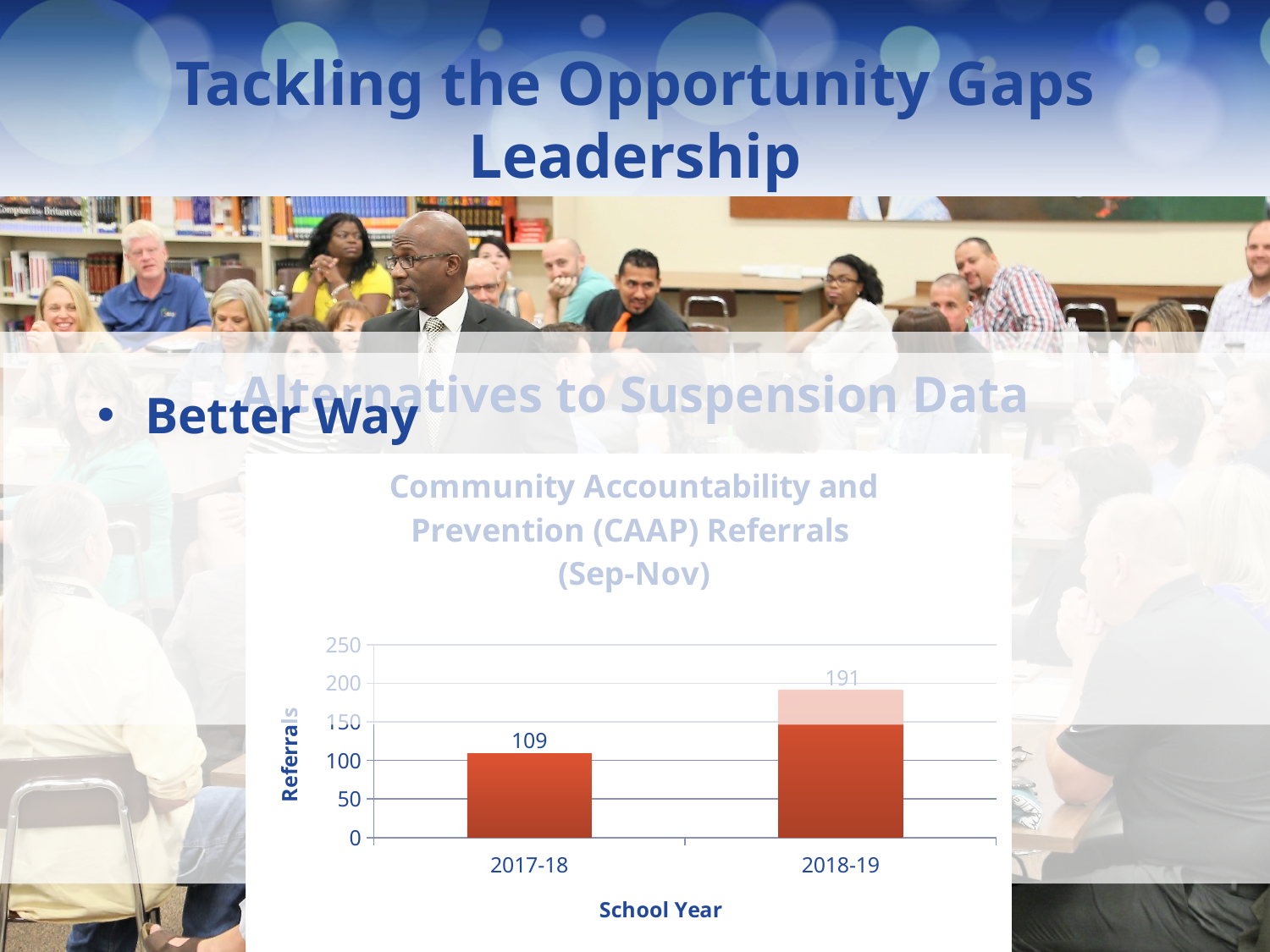
Which is larger, the referrals for 2017-18 or for 2018-19? 2018-19 What is the value for 2018-19 in the CAAP Referrals chart? 191 Is the value for 2017-18 greater or less than 150? less What is the difference in referrals between 2018-19 and 2017-18? 82 Which school year has the highest number of referrals in the chart? 2018-19 How many school years are shown in the chart? 2 What is the value for 2017-18 in the CAAP Referrals chart? 109 What kind of chart is shown on the slide? bar chart What is the label of the vertical axis of the chart? Referrals Is the value for 2018-19 greater or less than 150? greater Do the referral values rise or fall from 2017-18 to 2018-19? rise Which school year has the lowest number of referrals in the chart? 2017-18